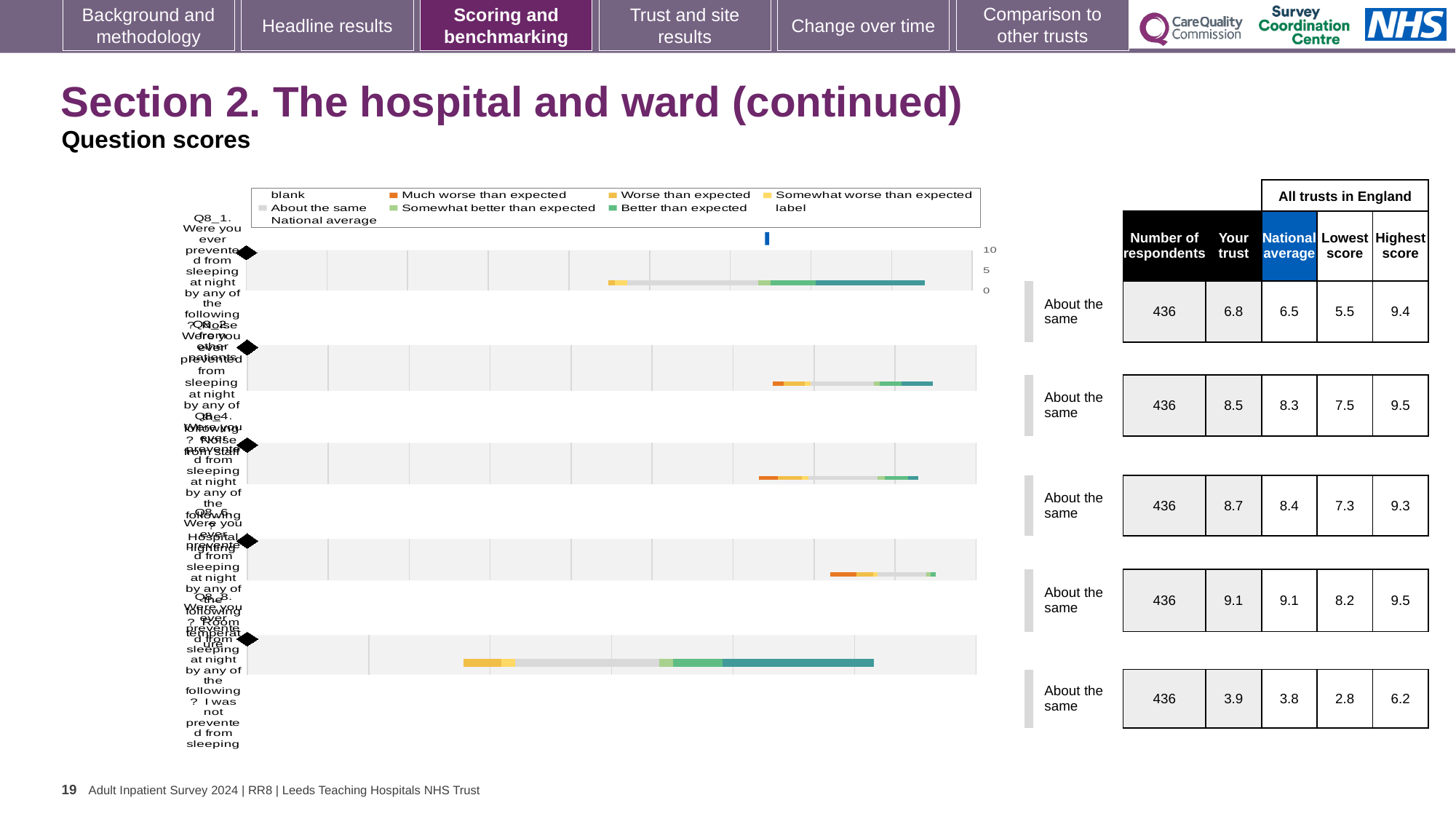
What colour does the legend use for 'Much worse than expected'? orange What is the highest score among all trusts in England for the second question row? 9.5 Which question row has the lowest 'Your trust' score? the bottom row (3.9) What is the national average for the bottom question row? 3.8 What kind of chart is shown on the slide? bar chart What is the number of respondents shown for the top question row? 436 How many question rows (bars) does the chart show? 5 What benchmark category is shown next to every question row? About the same For the top question row, which is larger: the 'Your trust' score or the national average? Your trust (6.8) For the top question row, what is the difference between the highest score and the lowest score among all trusts in England? 3.9 What is the 'Your trust' score for the first (top) question row? 6.8 Which question row has the highest 'Your trust' score? the fourth row (9.1)